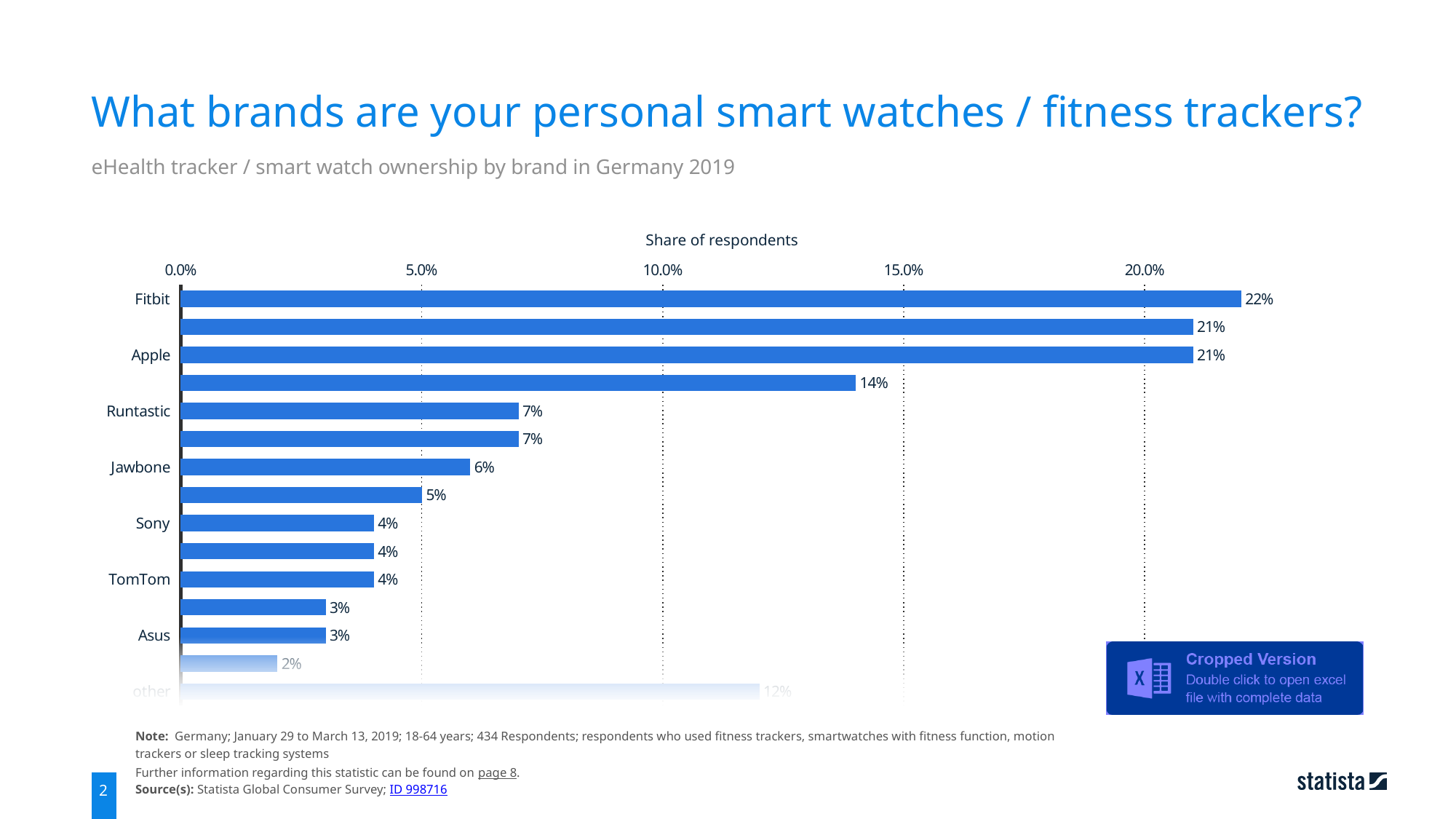
What is the title of the horizontal axis? Share of respondents What kind of chart is shown on the slide? Bar chart What share of respondents own a Fitbit smart watch / fitness tracker? 22% What share of respondents is shown for Runtastic? 7% Which brand has the highest share of respondents? Fitbit What is the value shown for Apple? 21% What share of respondents is shown for Sony? 4% What is the value shown for Asus? 3% What is the difference in percentage points between Fitbit and Apple? 1 percentage point What is the value for Jawbone? 6% Which has a larger share of respondents, Runtastic or Jawbone? Runtastic What is the difference in percentage points between Apple and Runtastic? 14 percentage points